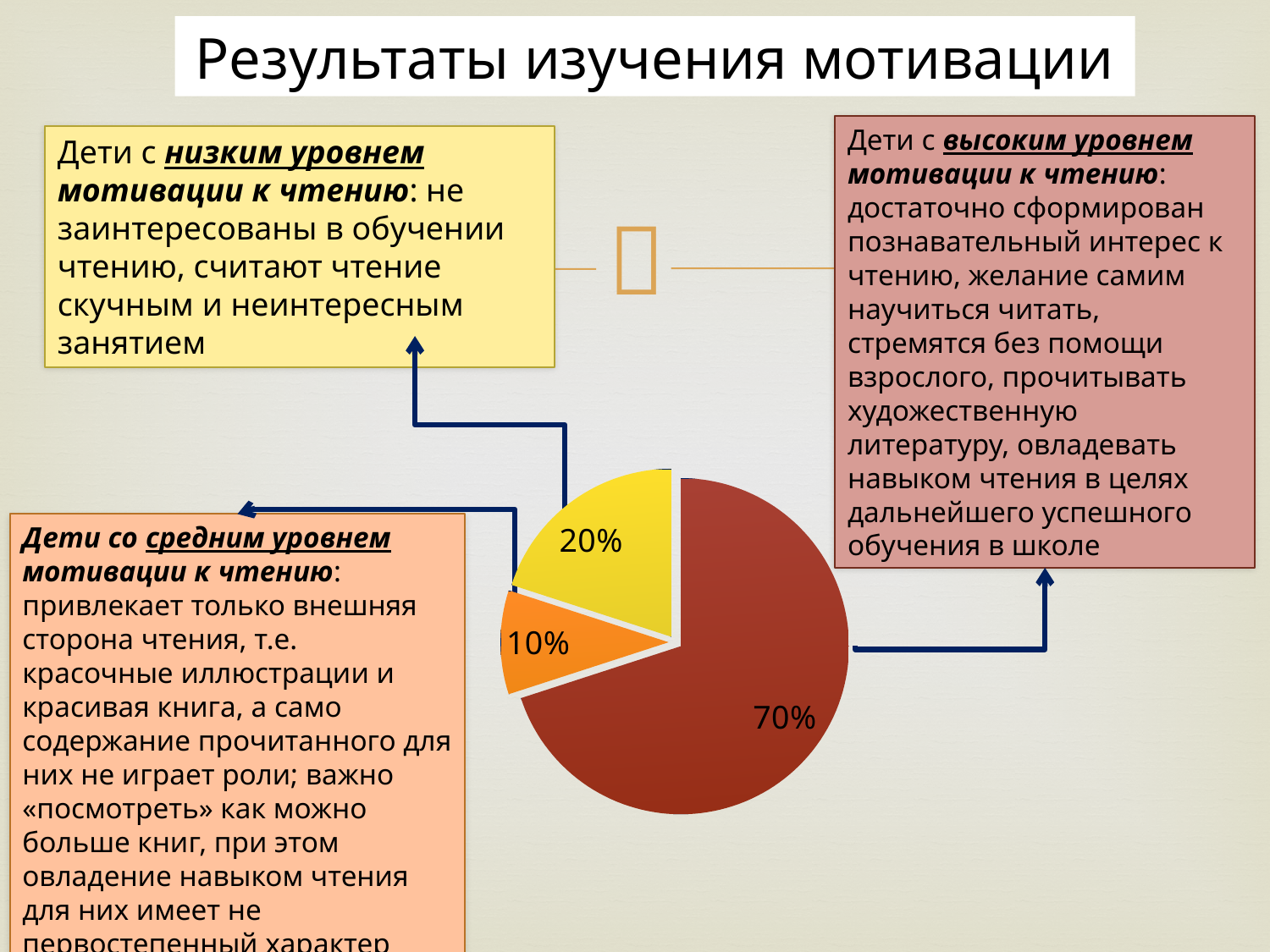
What percentage is shown on the yellow slice of the pie chart? 20% What is the largest slice of the pie chart? 70% Which slice is larger, the yellow one or the orange one? the yellow one (20%) What percentage is shown on the orange slice of the pie chart? 10% What percentage is shown on the dark red slice of the pie chart? 70% How many slices does the pie chart have? 3 What share of the pie is linked by the arrow to the box about children with a high level of reading motivation (высоким уровнем мотивации к чтению)? 70% What is the smallest slice of the pie chart? 10% What is the title of the slide containing the pie chart? Результаты изучения мотивации What kind of chart is shown on the slide? pie chart What is the difference between the largest and the smallest slice of the pie chart? 60% What share of the pie is linked by the arrow to the box about children with a low level of reading motivation (низким уровнем мотивации к чтению)? 20%